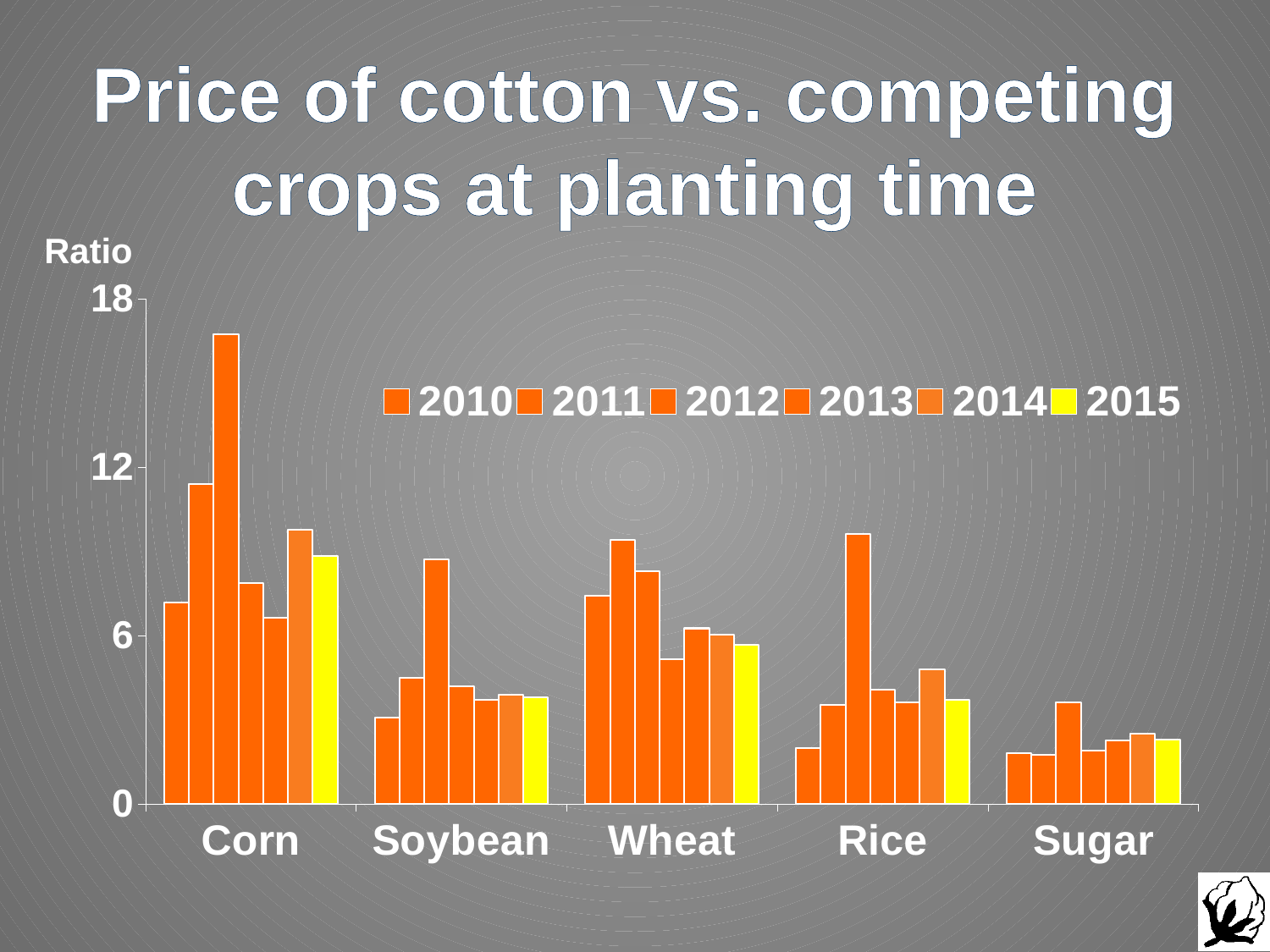
What is the title of the chart? Price of cotton vs. competing crops at planting time Is the tallest bar for Corn greater or less than 12? greater Which crop category contains the tallest bar in the chart? Corn How many crop categories are shown on the x axis? 5 Is the 2015 value for Sugar greater or less than 6? less Is the 2015 value for Corn greater or less than 6? greater Which crop category has the lowest bars overall? Sugar Which is larger, the 2015 value for Corn or the 2015 value for Sugar? Corn What kind of chart is shown on the slide? bar chart What label is shown on the vertical axis? Ratio How many series does the legend list? 6